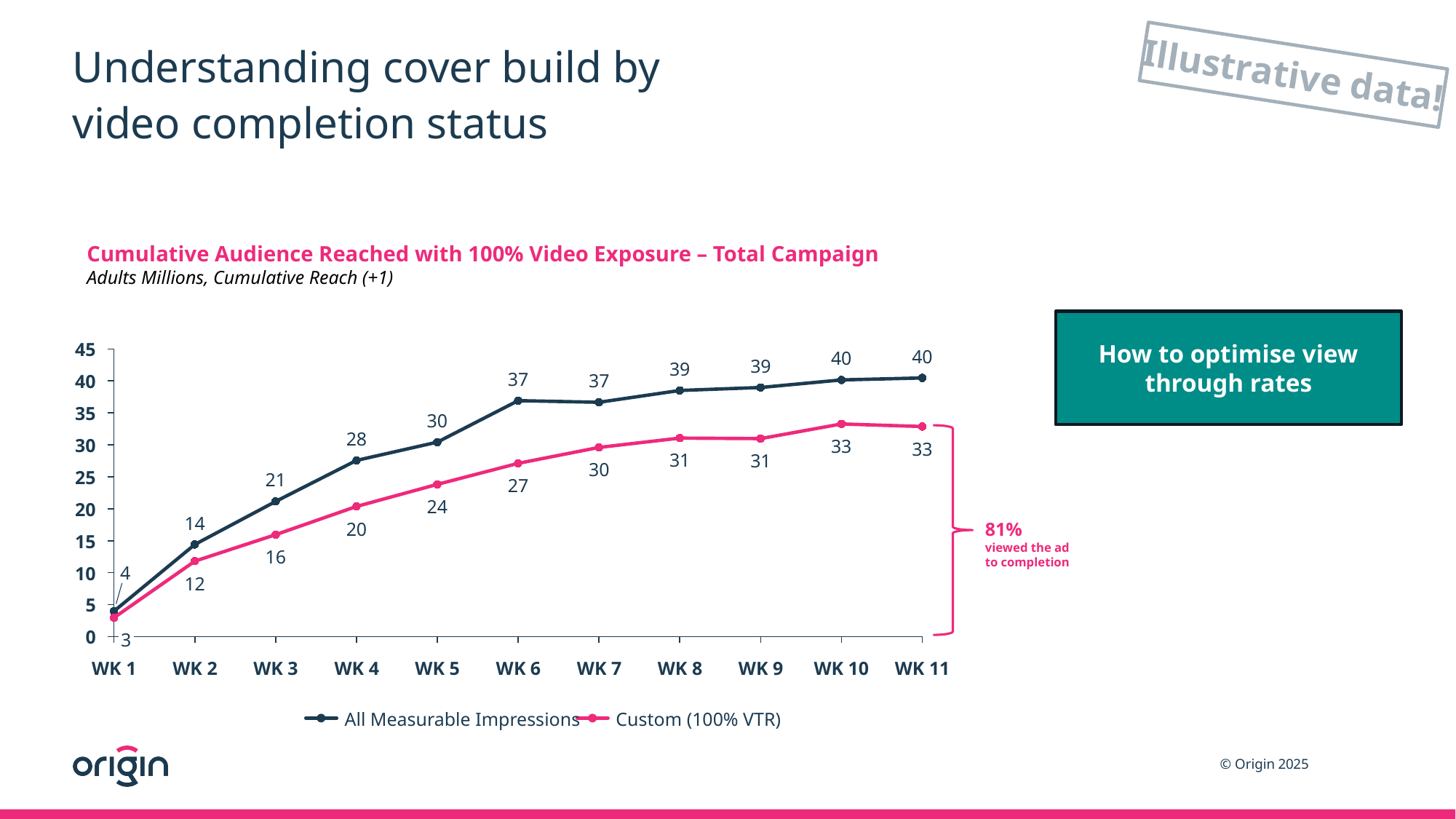
What is the value for Custom (100% VTR) at WK 4? 20 How many weeks are shown on the x axis? 11 What kind of chart is shown? Line chart What is the difference between All Measurable Impressions and Custom (100% VTR) at WK 5? 6 Does the Custom (100% VTR) series generally rise or fall from WK 1 to WK 11? Rise What percentage is shown next to the bracket on the right of the chart as having viewed the ad to completion? 81% How many series does the legend list? 2 What is the value for Custom (100% VTR) at WK 11? 33 What is the value for All Measurable Impressions at WK 6? 37 At which week is the All Measurable Impressions series lowest? WK 1 Which series has the higher value at WK 8, All Measurable Impressions or Custom (100% VTR)? All Measurable Impressions What is the title of the chart? Cumulative Audience Reached with 100% Video Exposure – Total Campaign